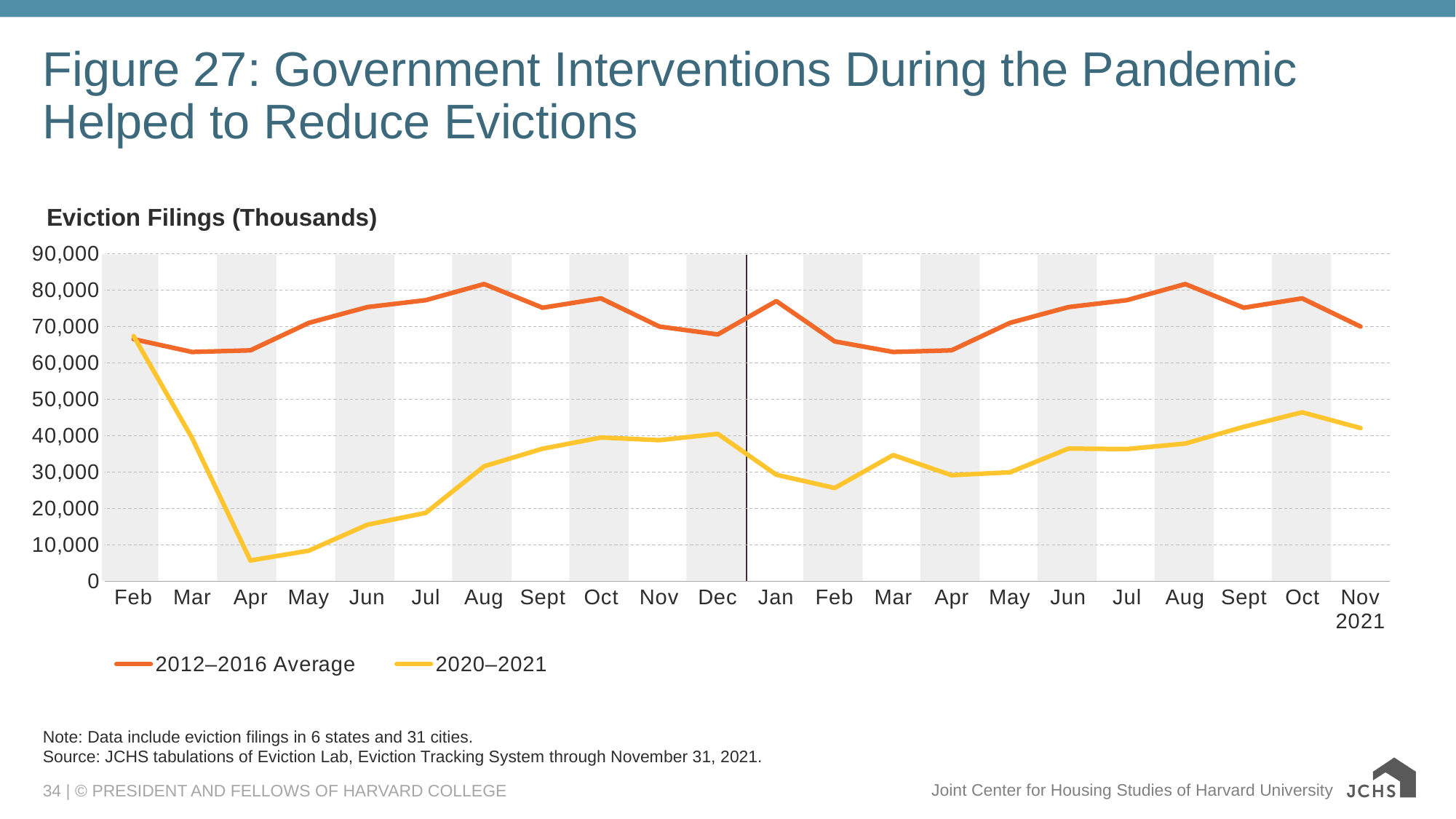
Does the 2020–2021 series rise or fall from Apr 2020 to Oct 2020? Rise What is the axis title shown above the chart? Eviction Filings (Thousands) In Mar 2020, which series has the higher value, 2012–2016 Average or 2020–2021? 2012–2016 Average What colour is the line for the 2020–2021 series? Yellow In which month does the 2020–2021 series reach its highest value? Oct 2021 What kind of chart is shown on the slide? Line chart In which month does the 2020–2021 series reach its lowest value? Apr (2020) Is the value for the 2020–2021 series in Feb 2021 greater or less than 30,000? less How many series does the legend list? 2 Is the value for the 2020–2021 series in Apr 2020 greater or less than 10,000? less How many months are plotted along the x axis? 22 Is the value for the 2012–2016 Average in Aug greater or less than 80,000? greater